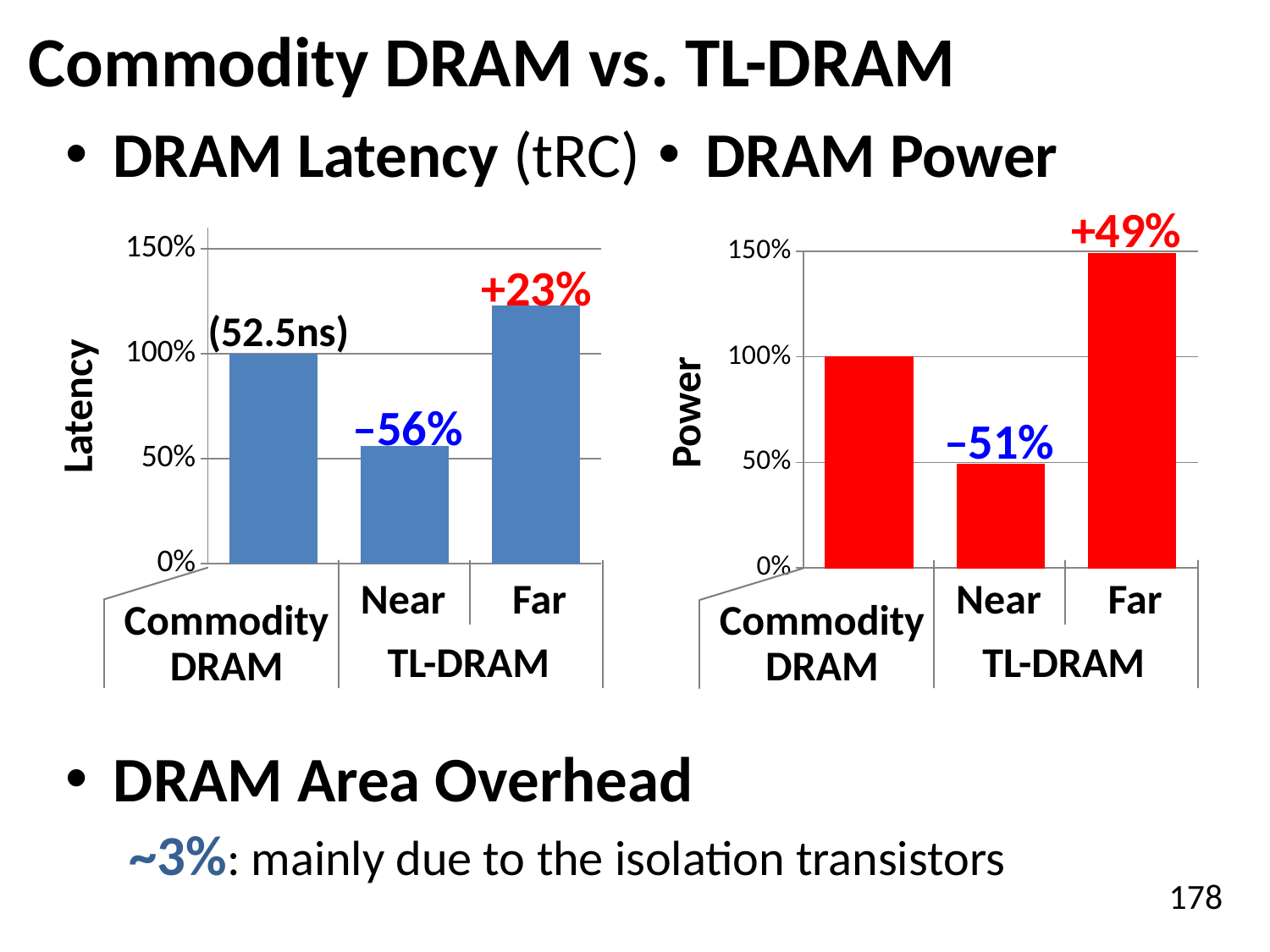
On the DRAM Latency chart, what label is shown above the TL-DRAM Far bar? +23% How many bars are plotted on the DRAM Power chart? 3 On the DRAM Latency chart, is the value for TL-DRAM Far greater or less than 100%? greater What type of chart is the DRAM Latency chart? Bar chart On the DRAM Latency chart, what percentage does the Commodity DRAM bar reach? 100% On the DRAM Latency chart, what absolute latency is given in parentheses for Commodity DRAM? 52.5ns On the DRAM Power chart, is the value for TL-DRAM Near greater or less than 100%? less On the DRAM Latency chart, which bar is the lowest? TL-DRAM Near On the DRAM Power chart, which bar is the highest? TL-DRAM Far On the DRAM Latency chart, what label is shown above the TL-DRAM Near bar? –56% On the DRAM Power chart, what label is shown above the TL-DRAM Far bar? +49% On the DRAM Power chart, what label is shown above the TL-DRAM Near bar? –51%